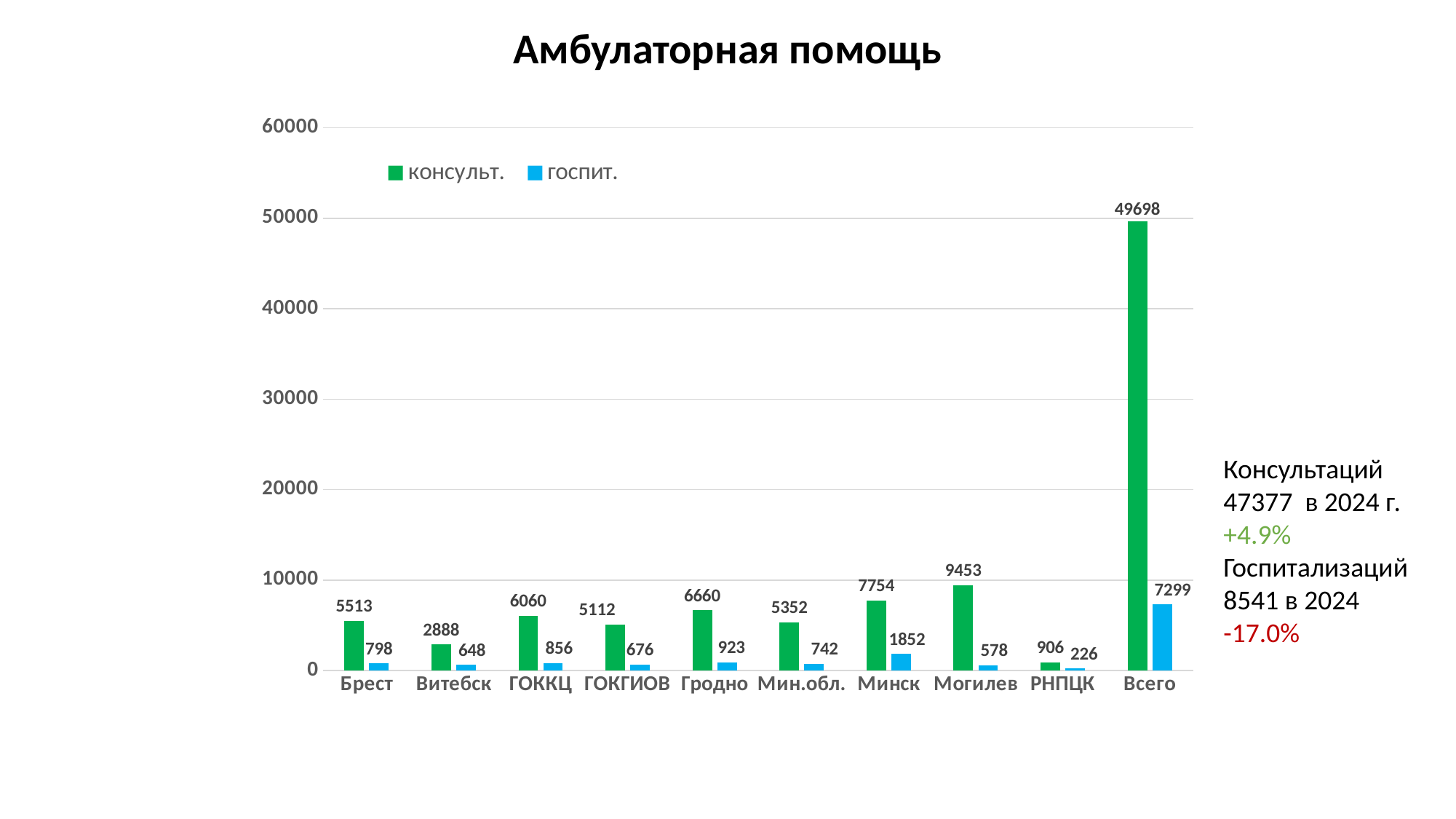
Excluding Всего, which category has the highest консульт. value? Могилев What is the value of госпит. for Гродно? 923 Which is larger, the госпит. value for Минск or for Брест? Минск Is the консульт. value for Всего greater or less than 40000? greater What is the value of консульт. for Всего? 49698 Which category has the lowest госпит. value? РНПЦК How many series does the legend list? 2 What type of chart is shown on the slide? bar chart What is the value of консульт. for Минск? 7754 What is the difference between the консульт. values for Могилев and Минск? 1699 What is the value of госпит. for РНПЦК? 226 How many categories are shown on the x axis? 10